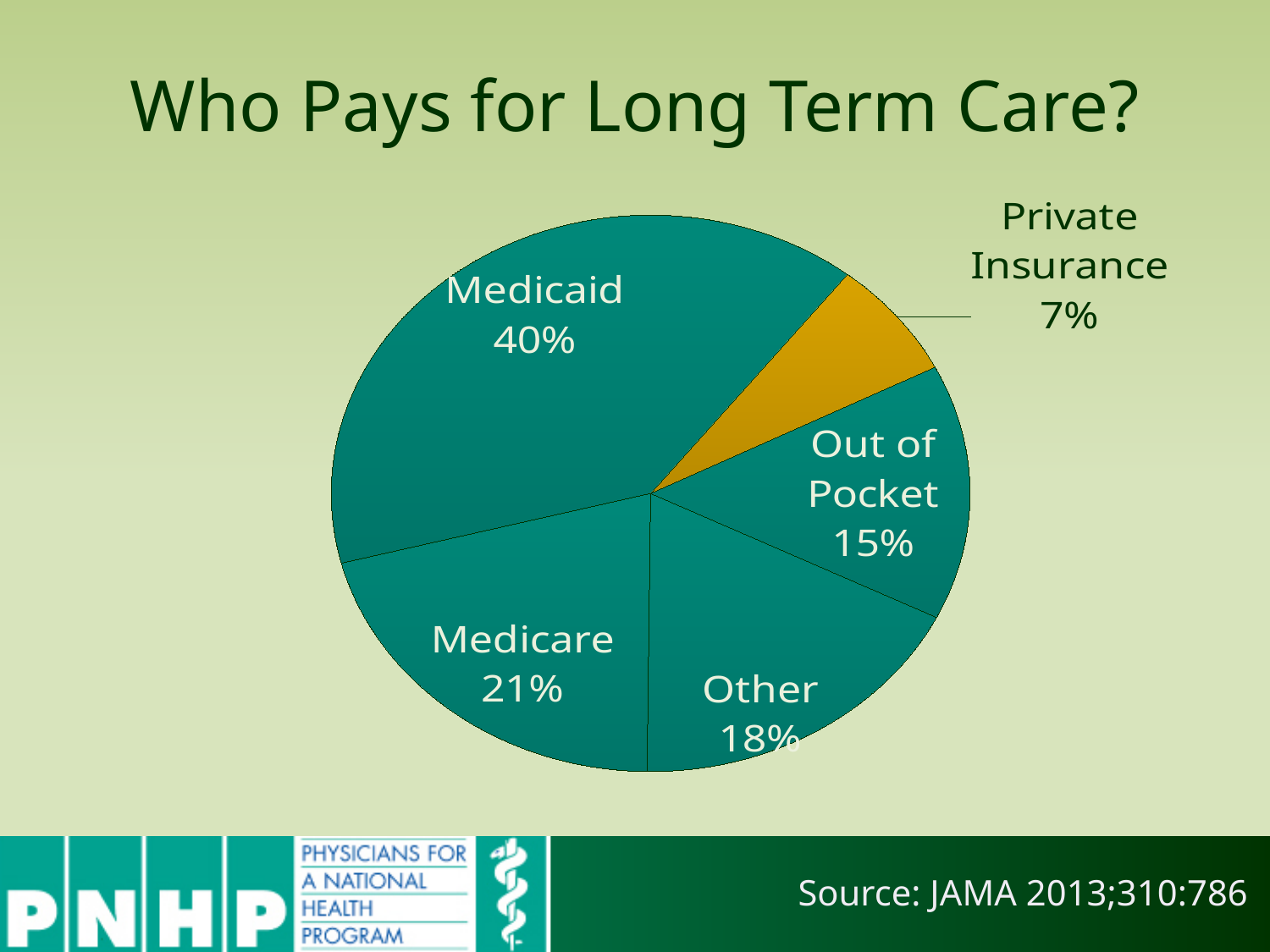
What kind of chart is shown on the slide? Pie chart What is the title of the slide? Who Pays for Long Term Care? What percentage is shown for Out of Pocket? 15% What percentage is shown for Private Insurance? 7% What percentage is shown for Medicare? 21% What percentage is shown for Other? 18% Which payer has the smallest slice of the pie? Private Insurance How many slices does the pie chart have? 5 How many percentage points larger is Medicaid's share than Medicare's? 19 Which payer has the largest slice of the pie? Medicaid What share of long term care payment comes from Medicaid? 40% Which is larger, the share for Other or the share for Out of Pocket? Other